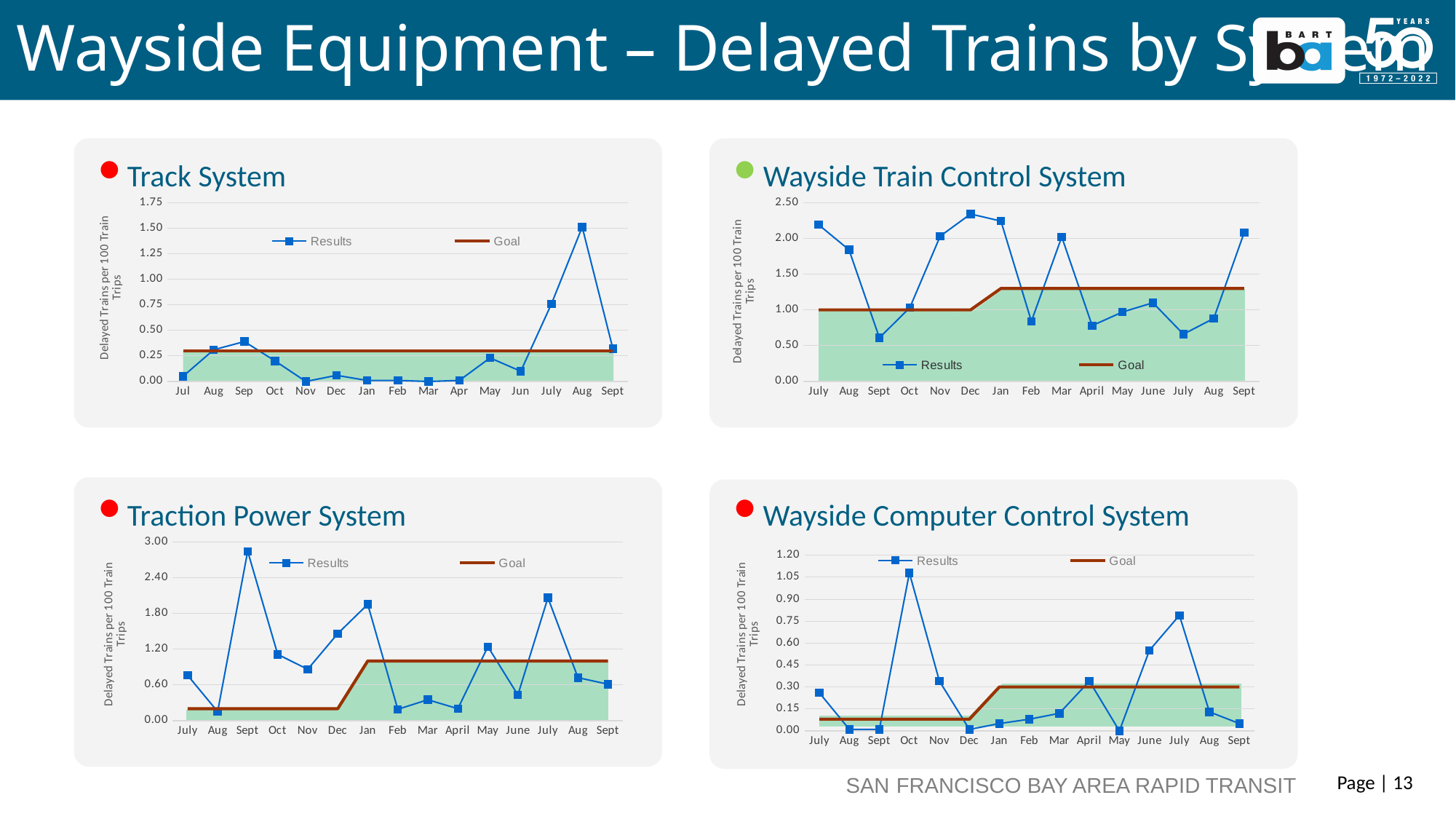
What type of chart is used for the Track System? Line chart How many series does the legend list in the Traction Power System chart? 2 In the Track System chart, which month has the highest Results value? Aug In the Track System chart, is the Results value for the second Aug greater or less than 1.25? greater In the Traction Power System chart, which month has the highest Results value? Sept In the Traction Power System chart, is the Results value for Jan greater or less than the value for Dec? greater How many months are plotted on the x axis of the Wayside Computer Control System chart? 15 In the Wayside Train Control System chart, is the Results value for the first July greater or less than 2.00? greater In the Wayside Computer Control System chart, is the Results value for Oct greater or less than 0.90? greater What is the y-axis label on the Track System chart? Delayed Trains per 100 Train Trips In the Wayside Computer Control System chart, which month has the highest Results value? Oct